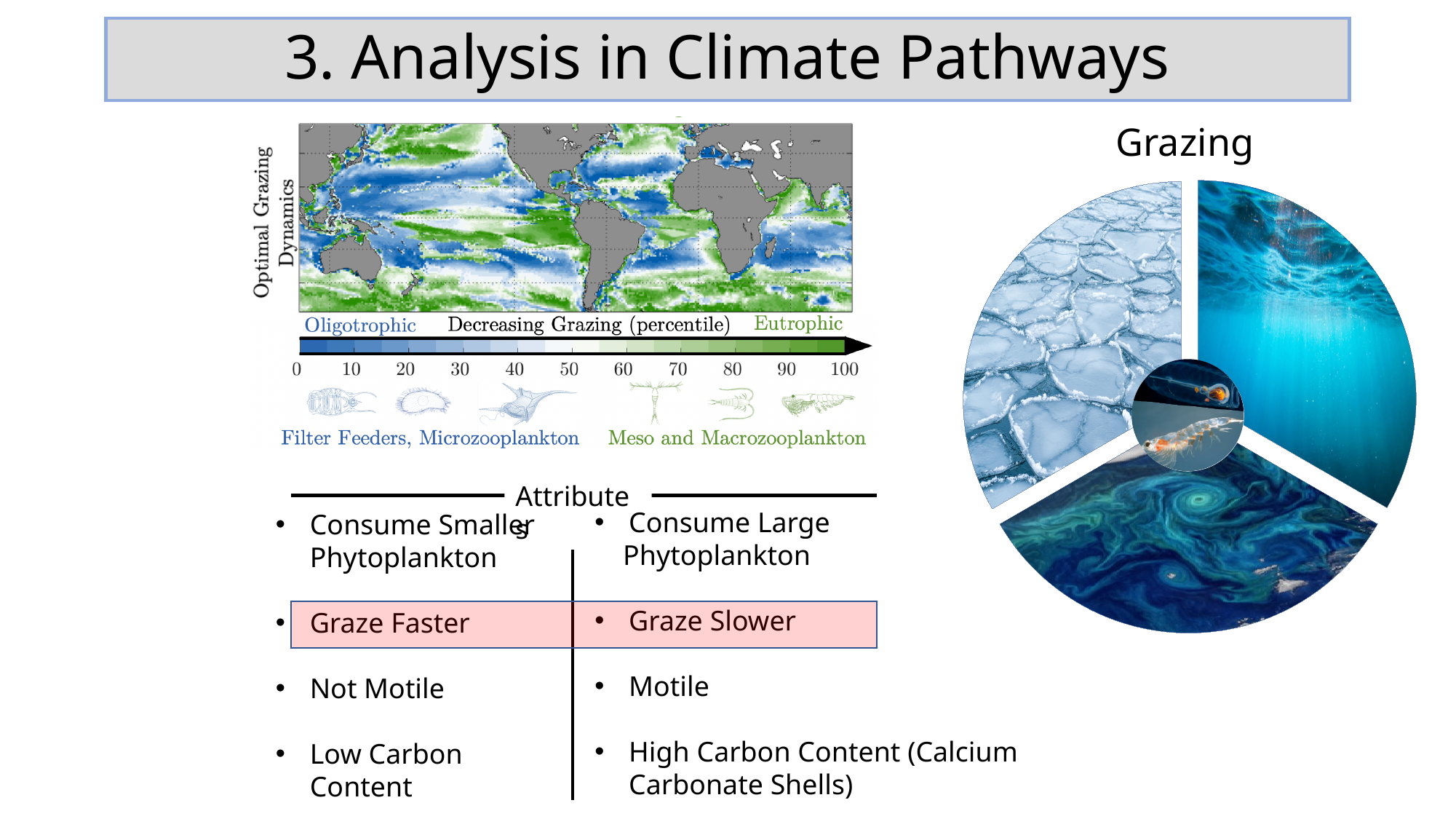
What is the title of the pie chart on the right side of the slide? Grazing What kind of chart is the one titled "Grazing" on the right of the slide? pie chart On the map chart on the left, how many tick values are printed along the colour bar? 11 On the map chart on the left, what is the lowest value shown on the colour bar scale? 0 On the map chart on the left, what is the highest value shown on the colour bar scale? 100 How many slices does the "Grazing" pie chart on the right have? 3 On the map chart on the left, what label is printed above the colour bar between "Oligotrophic" and "Eutrophic"? Decreasing Grazing (percentile)